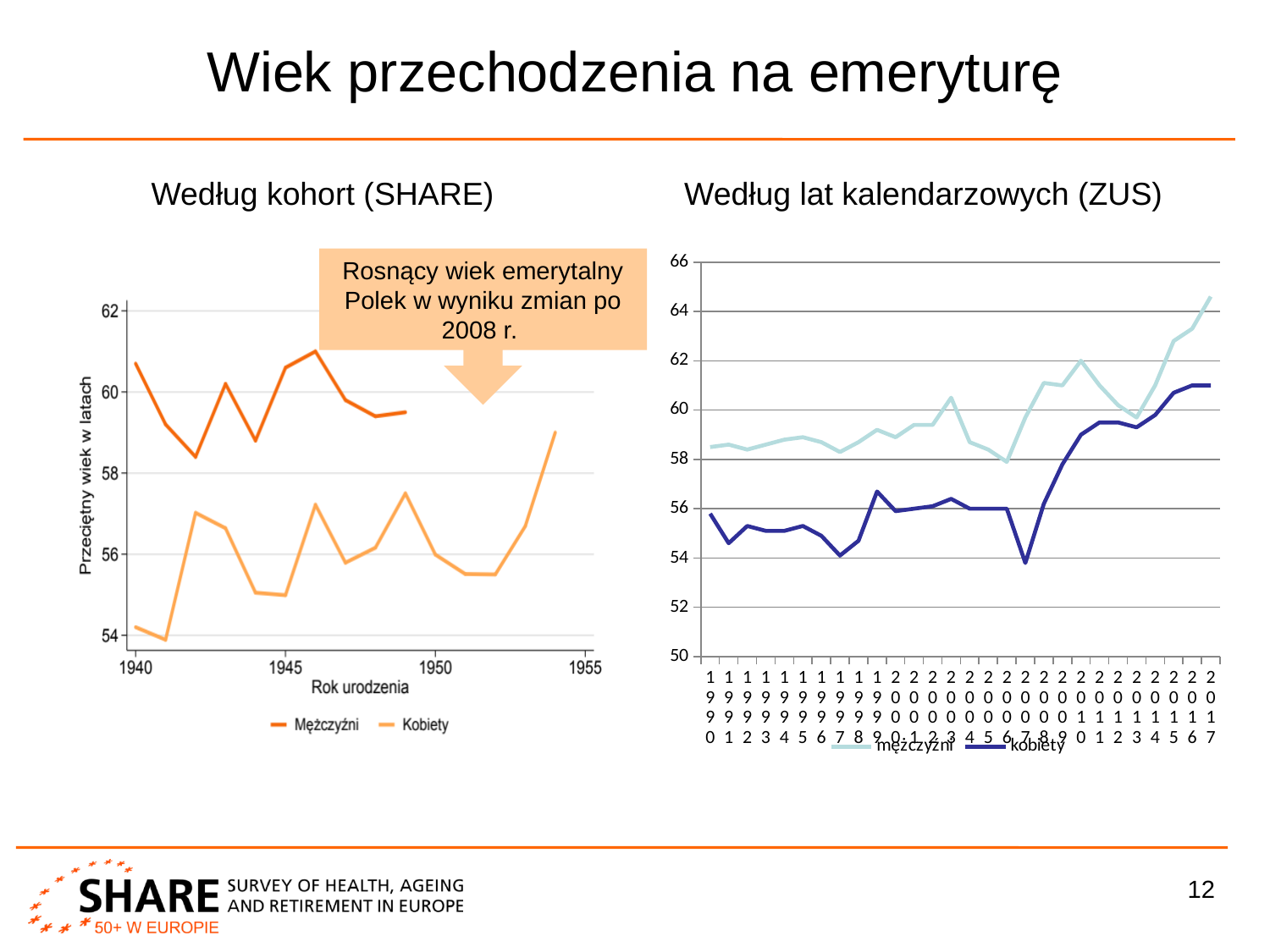
In the 'Według lat kalendarzowych (ZUS)' chart, which series is higher in 2017, mężczyźni or kobiety? mężczyźni In the 'Według lat kalendarzowych (ZUS)' chart, is the value for mężczyźni in 2017 greater or less than 62? greater In the 'Według lat kalendarzowych (ZUS)' chart, is the value for kobiety in 2017 greater or less than 60? greater In the 'Według kohort (SHARE)' chart, which birth year has the highest value for Kobiety? 1954 In the 'Według lat kalendarzowych (ZUS)' chart, does the kobiety line rise or fall between 2007 and 2017? rise How many series does the legend of the 'Według kohort (SHARE)' chart on the left list? 2 In the 'Według lat kalendarzowych (ZUS)' chart, how many years are shown on the x axis? 28 What kind of chart is the 'Według lat kalendarzowych (ZUS)' chart on the right? line chart In the 'Według kohort (SHARE)' chart, is the value for Kobiety for birth year 1944 greater or less than 56? less What is the label of the y axis of the 'Według kohort (SHARE)' chart on the left? Przeciętny wiek w latach In the 'Według lat kalendarzowych (ZUS)' chart, which year has the highest value for mężczyźni? 2017 In the 'Według lat kalendarzowych (ZUS)' chart, which year has the lowest value for kobiety? 2007